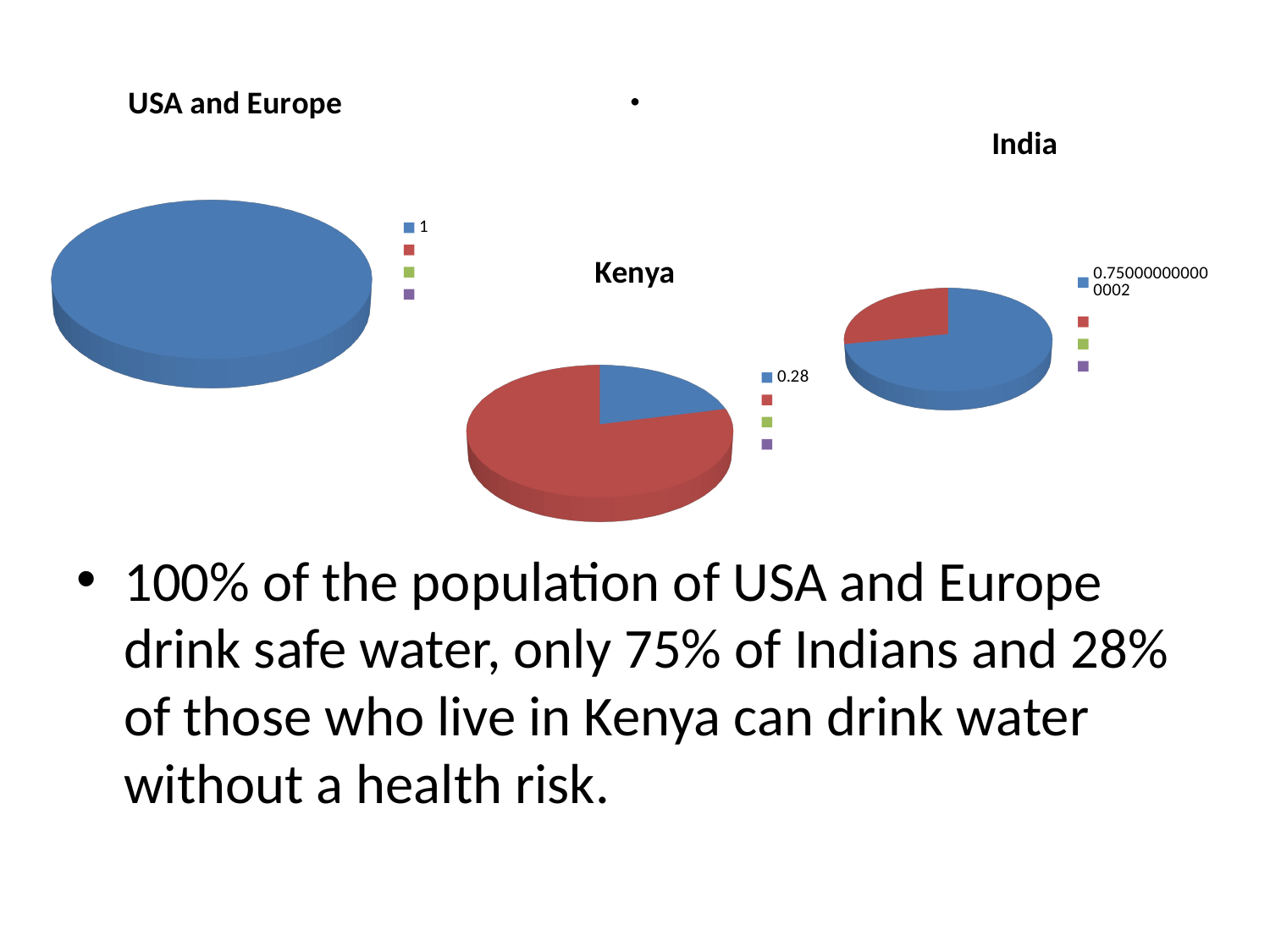
Which of the three pie charts has the largest blue slice? USA and Europe In the 'Kenya' chart, which slice is larger, the blue one or the red one? red What is the title of the pie chart on the left of the slide? USA and Europe How many pie charts are shown on the slide? 3 In the 'USA and Europe' chart, what is the legend label for the blue slice? 1 How many entries does the legend of the 'Kenya' chart list? 4 In the 'India' chart, which slice is larger, the blue one or the red one? blue What colour is the only slice shown in the 'USA and Europe' chart? blue In the 'Kenya' chart, what is the legend label for the blue slice? 0.28 What kind of chart is the 'Kenya' chart? pie chart In the 'India' chart, what is the legend label for the blue slice? 0.750000000000002 Which of the three pie charts has the smallest blue slice? Kenya